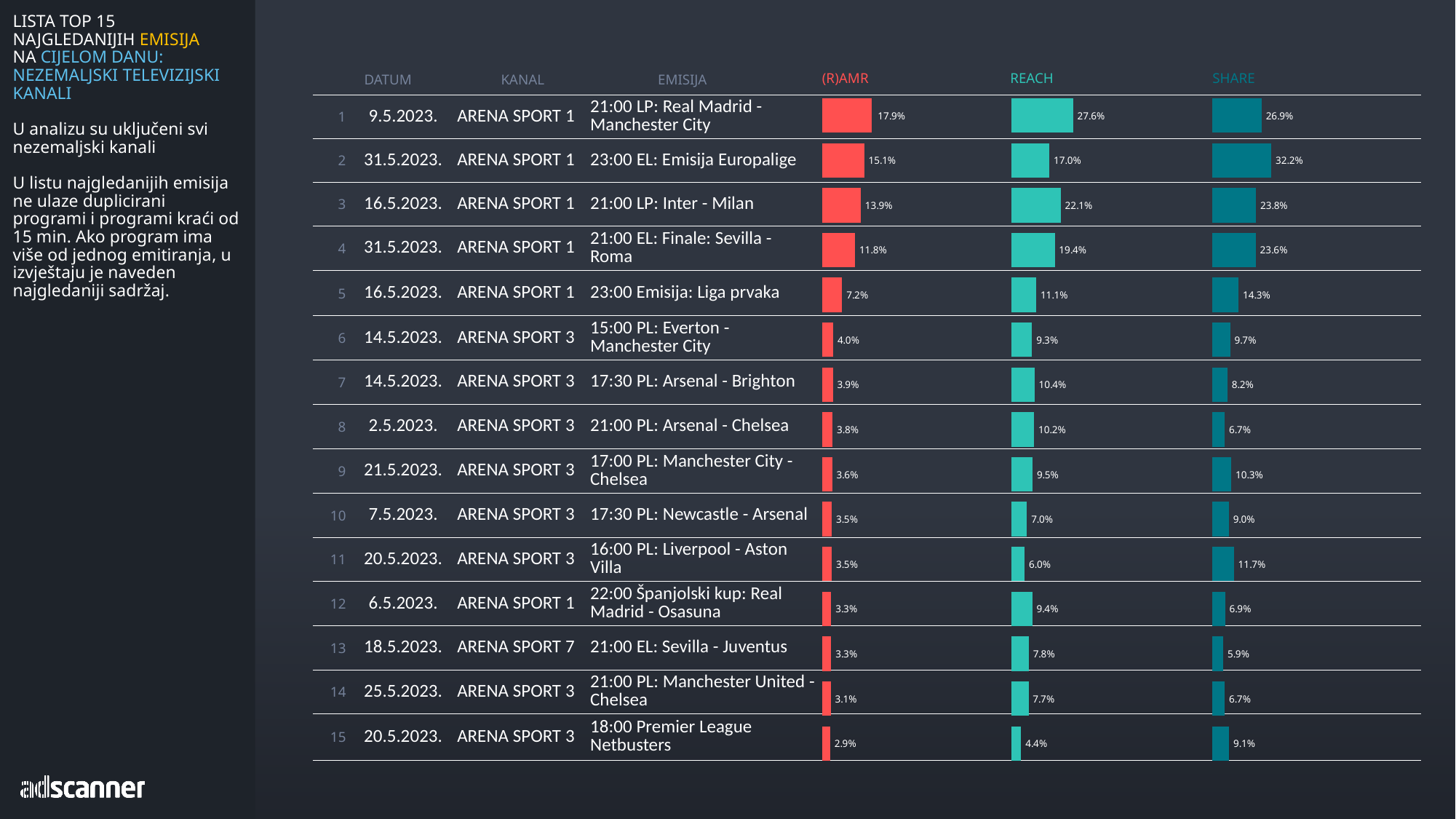
What is the SHARE value for 23:00 EL: Emisija Europalige? 32.2% Which programme has the lowest SHARE value? 21:00 EL: Sevilla - Juventus Do the (R)AMR values rise or fall going down the table from rank 1 to rank 15? Fall What is the REACH value for 21:00 LP: Inter - Milan? 22.1% What is the (R)AMR value for 21:00 LP: Real Madrid - Manchester City? 17.9% Which programme has the highest SHARE value? 23:00 EL: Emisija Europalige How many programmes are listed in the table? 15 What is the difference in REACH between 21:00 LP: Real Madrid - Manchester City and 23:00 EL: Emisija Europalige? 10.6% Which programme has the lowest REACH value? 18:00 Premier League Netbusters Which is larger, the SHARE for 21:00 EL: Finale: Sevilla - Roma or the SHARE for 21:00 LP: Inter - Milan? 21:00 LP: Inter - Milan What kind of chart is used to show the (R)AMR, REACH and SHARE values? Bar chart How many bar-chart metric columns does the table contain? 3